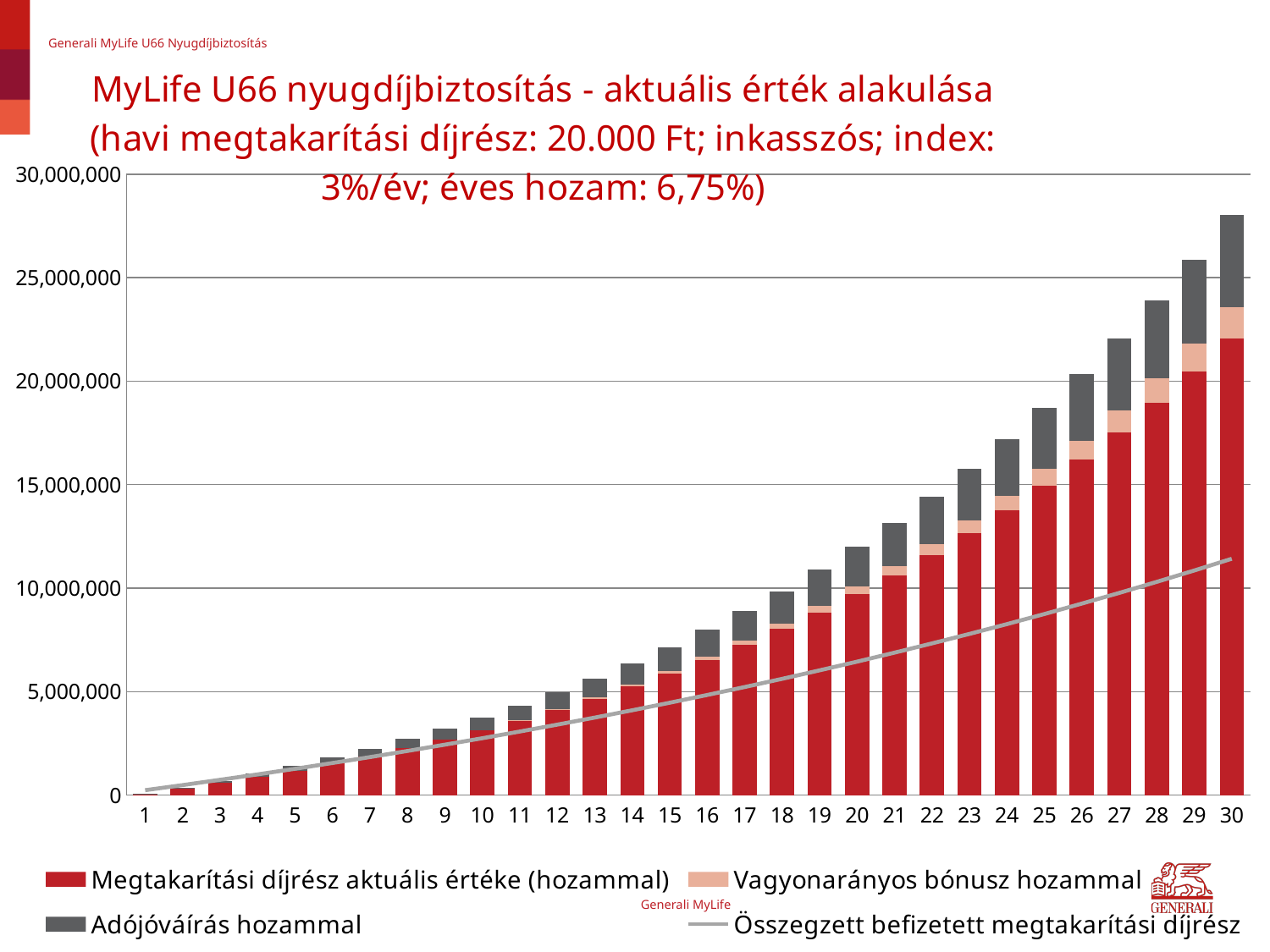
Which year has the lowest total bar? 1 Which is larger: the total bar for year 25 or the total bar for year 15? Year 25 How many categories (years) are shown on the x axis? 30 Is the total bar value for year 30 greater or less than 25,000,000? greater Which year has the highest total bar? 30 Is the value of the 'Összegzett befizetett megtakarítási díjrész' line at year 30 greater or less than 10,000,000? greater Do the stacked bar totals rise or fall from year 1 to year 30? Rise Which legend entry is shown with the grey line? Összegzett befizetett megtakarítási díjrész What kind of chart is shown on the slide? Stacked bar chart with a line How many series does the legend list? 4 Is the total bar value for year 10 greater or less than 5,000,000? less